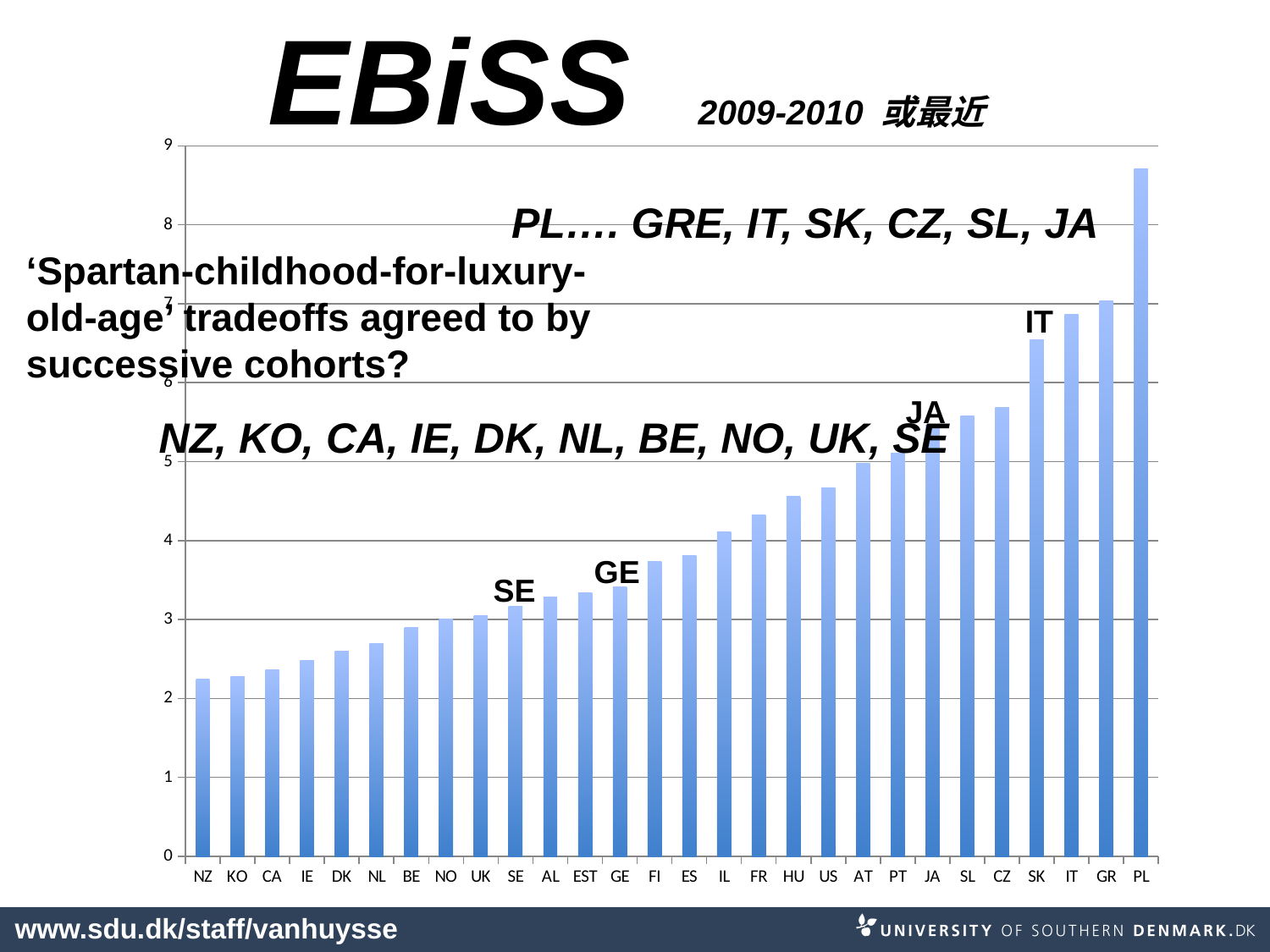
Which country has the highest bar in the chart? PL Is the value for PL greater or less than 8? greater Do the bar values rise or fall moving from left to right along the x axis? rise Which has the larger value, SK or JA? SK Is the value for NZ greater or less than 3? less Is the value for FR greater or less than 4? greater How many countries are shown along the x axis of the chart? 28 What is the title shown at the top of the slide above the chart? EBiSS What kind of chart is shown on the slide? bar chart Which country has the lowest bar in the chart? NZ